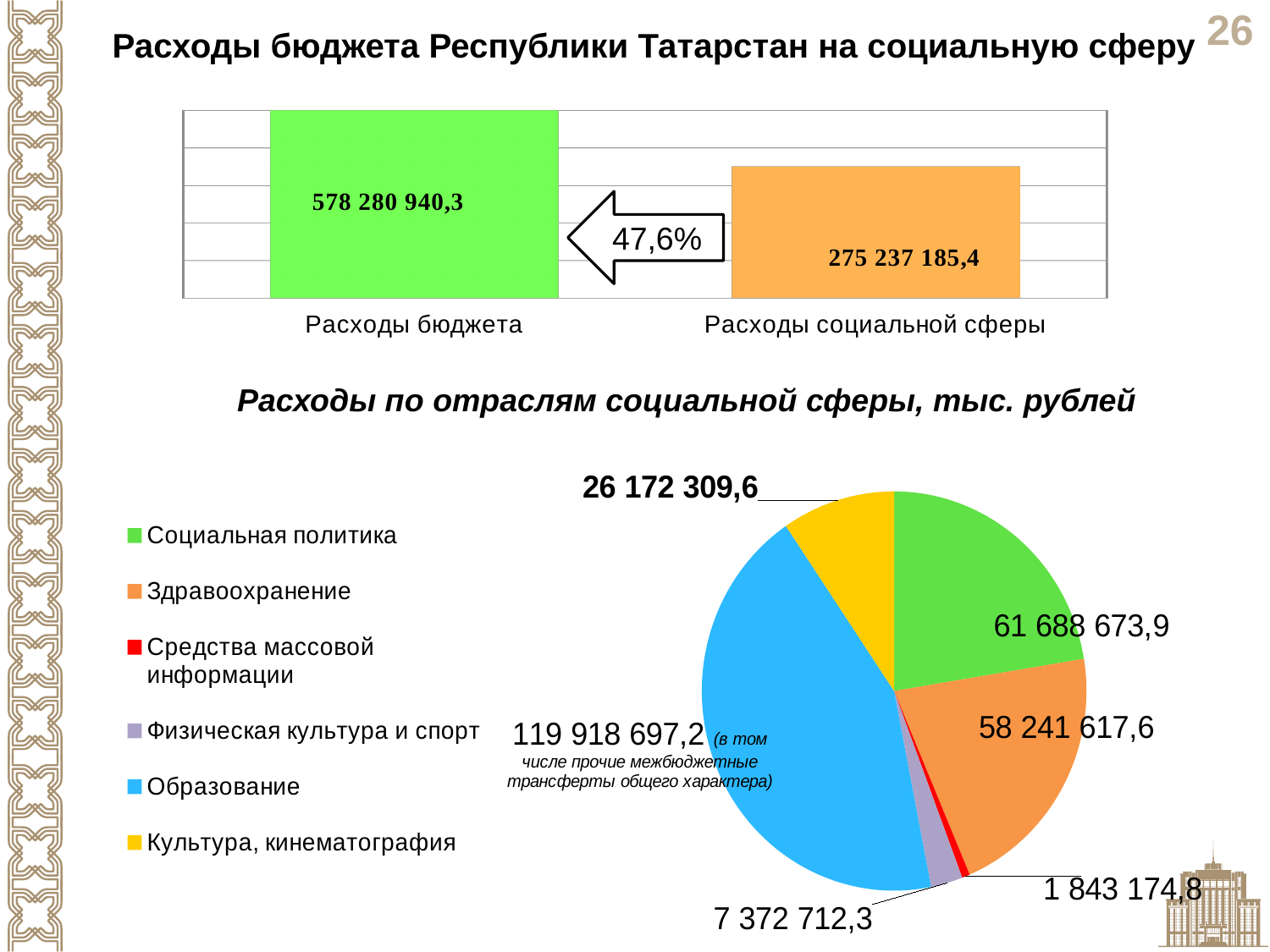
In the top bar chart, what percentage is shown on the arrow between the two bars? 47,6% In the pie chart 'Расходы по отраслям социальной сферы, тыс. рублей', which category has the smallest slice? Средства массовой информации In the top bar chart, what is the value for Расходы бюджета? 578 280 940,3 In the top bar chart, what is the difference between Расходы бюджета and Расходы социальной сферы? 303 043 754,9 In the pie chart 'Расходы по отраслям социальной сферы, тыс. рублей', how many categories does the legend list? 6 In the pie chart 'Расходы по отраслям социальной сферы, тыс. рублей', what is the value for Образование? 119 918 697,2 In the pie chart 'Расходы по отраслям социальной сферы, тыс. рублей', what is the value for Культура, кинематография? 26 172 309,6 In the pie chart 'Расходы по отраслям социальной сферы, тыс. рублей', what is the difference between Социальная политика and Здравоохранение? 3 447 056,3 In the top bar chart, what is the value for Расходы социальной сферы? 275 237 185,4 In the pie chart 'Расходы по отраслям социальной сферы, тыс. рублей', which category has the largest slice? Образование In the pie chart 'Расходы по отраслям социальной сферы, тыс. рублей', what is the value for Здравоохранение? 58 241 617,6 What type of chart is the top chart on the slide? bar chart